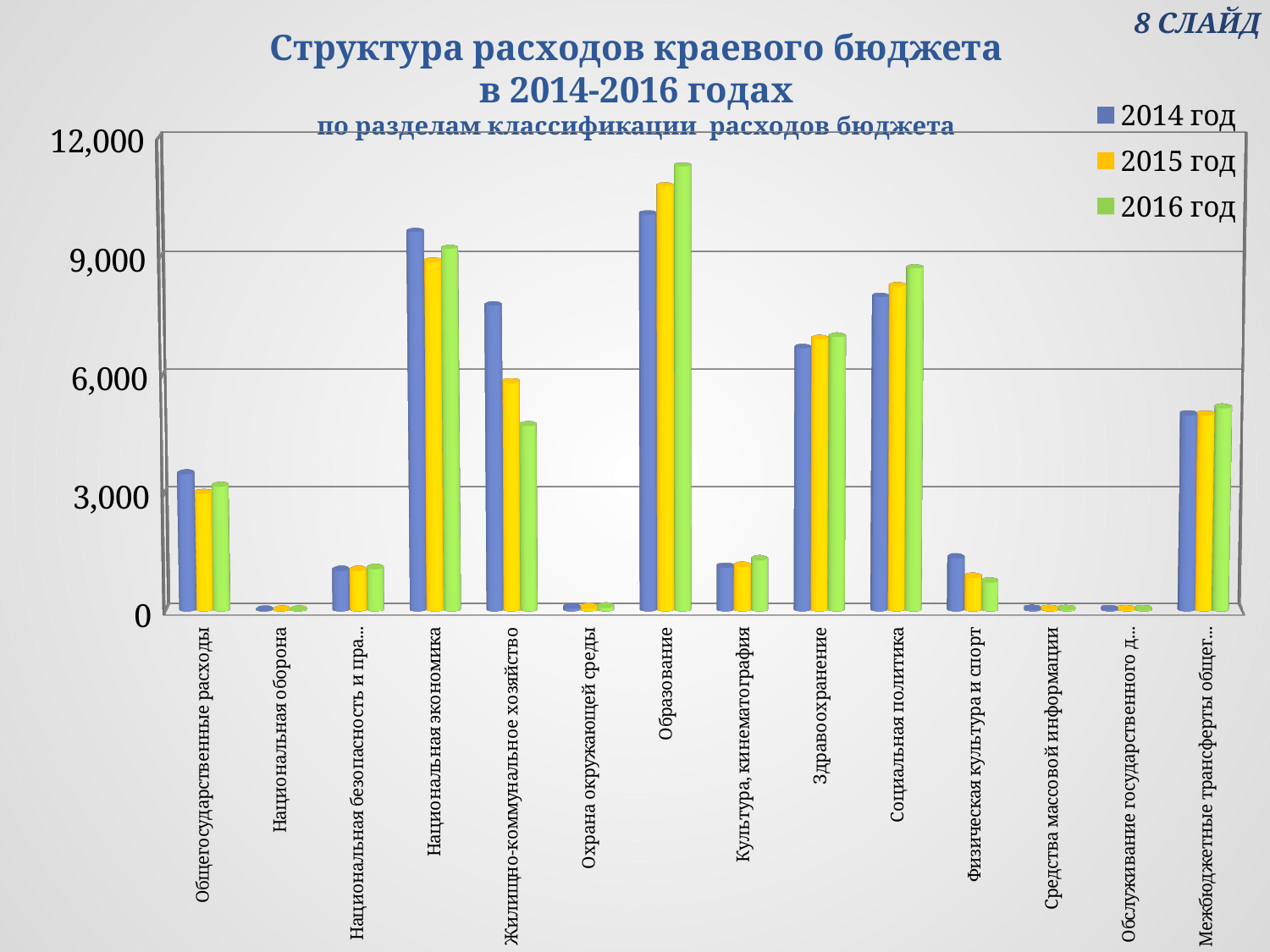
For Жилищно-коммунальное хозяйство, do the values rise or fall from 2014 год to 2016 год? fall Is the value for Социальная политика in 2014 год greater or less than 9,000? less Is the value for Жилищно-коммунальное хозяйство in 2016 год greater or less than 6,000? less Which series is shown in green in the legend? 2016 год How many series does the legend list? 3 Which is larger for 2016 год: Образование or Национальная экономика? Образование What kind of chart is shown on the slide? bar chart Is the value for Общегосударственные расходы in 2014 год greater or less than 3,000? greater How many categories are shown along the x axis? 14 Which category has the highest value for 2016 год? Образование Which category has the highest value for 2014 год? Образование